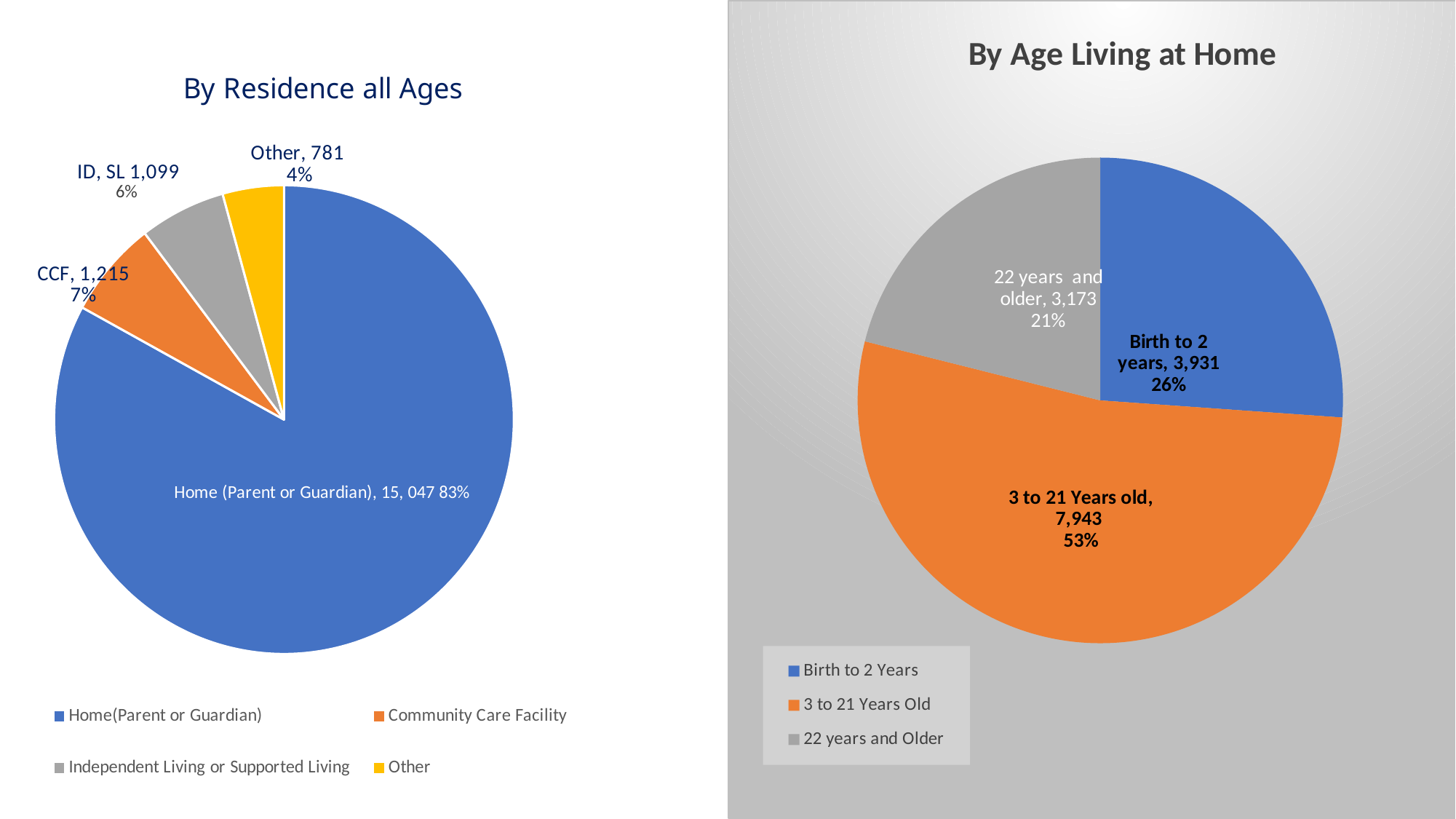
What type of chart is 'By Age Living at Home'? Pie chart In the 'By Residence all Ages' chart, what percentage share does the Other slice have? 4% In the 'By Residence all Ages' chart, how many slices does the pie have? 4 In the 'By Residence all Ages' chart, what is the difference between the CCF value and the ID, SL value? 116 In the 'By Age Living at Home' chart, what percentage share does 22 years and older have? 21% In the 'By Age Living at Home' chart, what value is shown for 3 to 21 Years old? 7,943 In the 'By Age Living at Home' chart, which is larger: Birth to 2 years or 22 years and older? Birth to 2 years In the 'By Residence all Ages' chart, what value is shown for CCF? 1,215 In the 'By Residence all Ages' chart, which category has the smallest slice? Other In the 'By Age Living at Home' chart, what is the difference between the Birth to 2 years value and the 22 years and older value? 758 In the 'By Age Living at Home' chart, which category has the largest slice? 3 to 21 Years old In the 'By Residence all Ages' chart, what percentage share does Home (Parent or Guardian) have? 83%